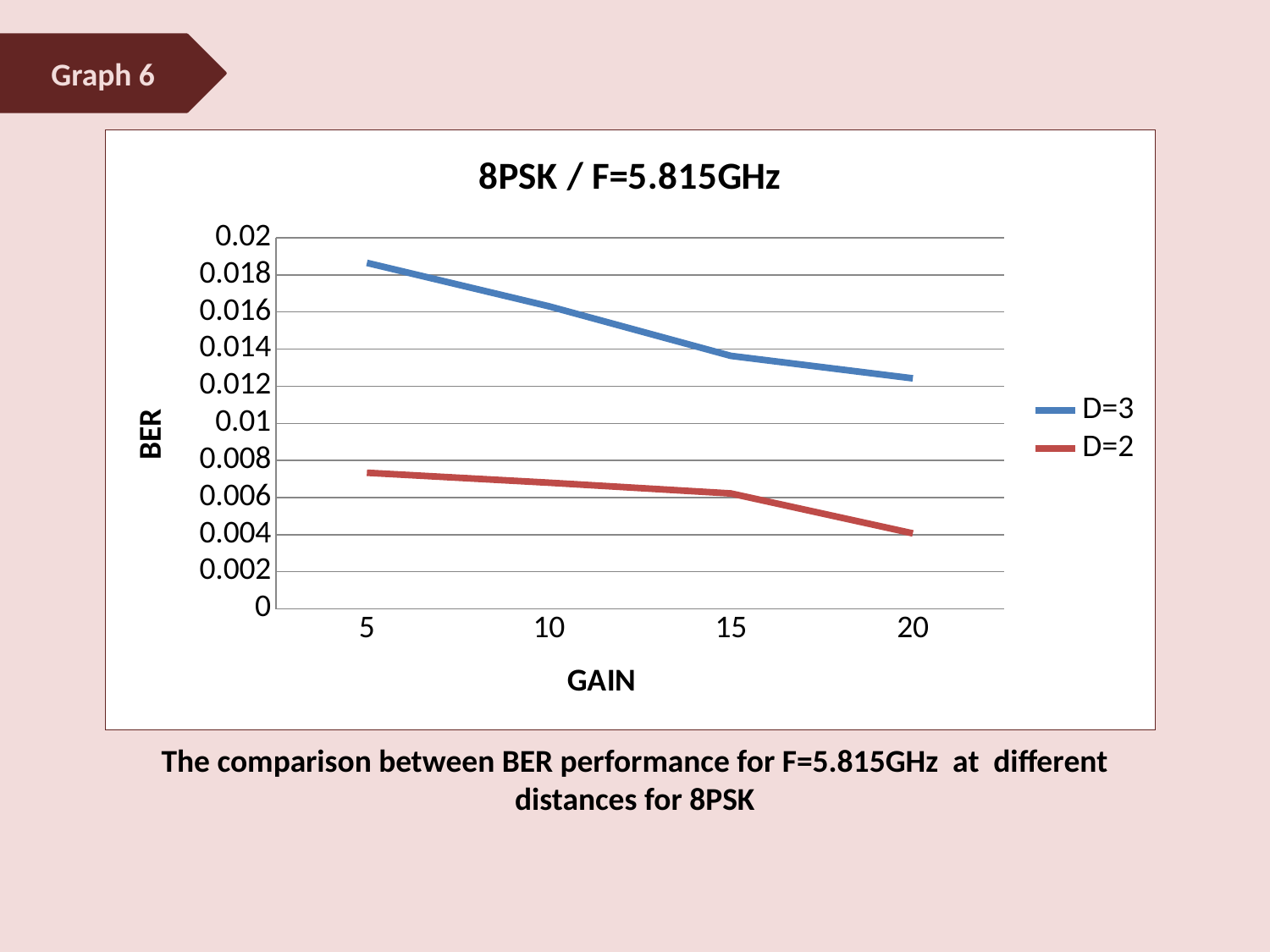
Is the BER value for D=3 at GAIN 5 greater or less than 0.018? greater What is the title of the chart? 8PSK / F=5.815GHz Do the BER values for D=3 rise or fall as GAIN increases? fall Is the BER value for D=2 at GAIN 20 greater or less than 0.006? less How many series does the legend list? 2 Is the BER value for D=2 at GAIN 5 greater or less than 0.008? less What is the label of the vertical axis? BER What kind of chart is shown on the slide? line chart At GAIN 5, which series has the higher BER, D=3 or D=2? D=3 Do the BER values for D=2 rise or fall as GAIN increases? fall At GAIN 20, which series has the lower BER, D=3 or D=2? D=2